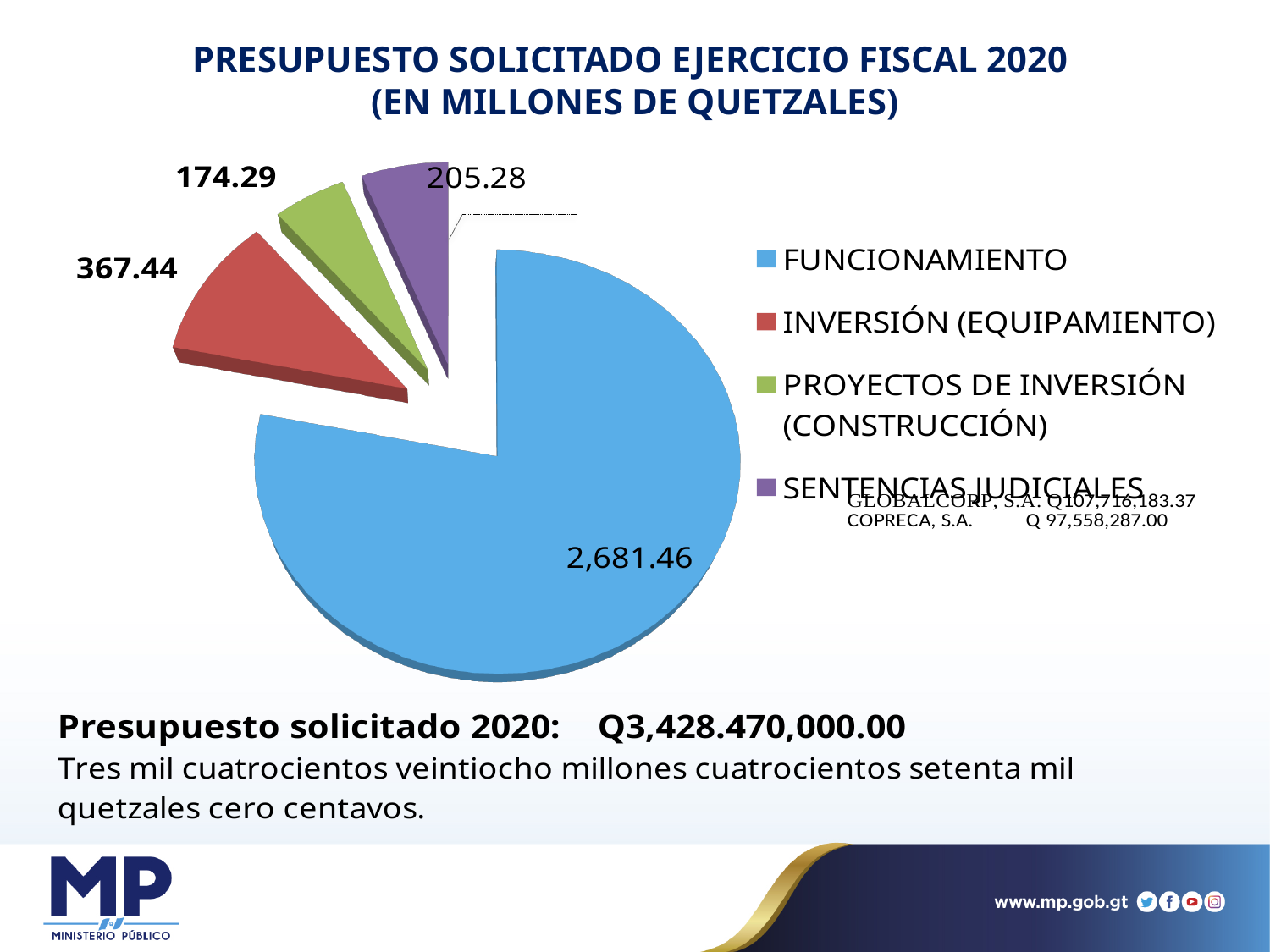
Which category has the largest slice of the pie? FUNCIONAMIENTO What is the value for FUNCIONAMIENTO? 2,681.46 Which category has the smallest slice of the pie? PROYECTOS DE INVERSIÓN (CONSTRUCCIÓN) What is the difference between the values for INVERSIÓN (EQUIPAMIENTO) and PROYECTOS DE INVERSIÓN (CONSTRUCCIÓN)? 193.15 How many categories does the pie chart have? 4 What type of chart is shown on the slide? Pie chart What is the value for SENTENCIAS JUDICIALES? 205.28 What is the difference between the values for SENTENCIAS JUDICIALES and PROYECTOS DE INVERSIÓN (CONSTRUCCIÓN)? 30.99 Which is larger, the value for SENTENCIAS JUDICIALES or the value for INVERSIÓN (EQUIPAMIENTO)? INVERSIÓN (EQUIPAMIENTO) What colour is the FUNCIONAMIENTO slice? Blue What is the value for PROYECTOS DE INVERSIÓN (CONSTRUCCIÓN)? 174.29 What is the value for INVERSIÓN (EQUIPAMIENTO)? 367.44